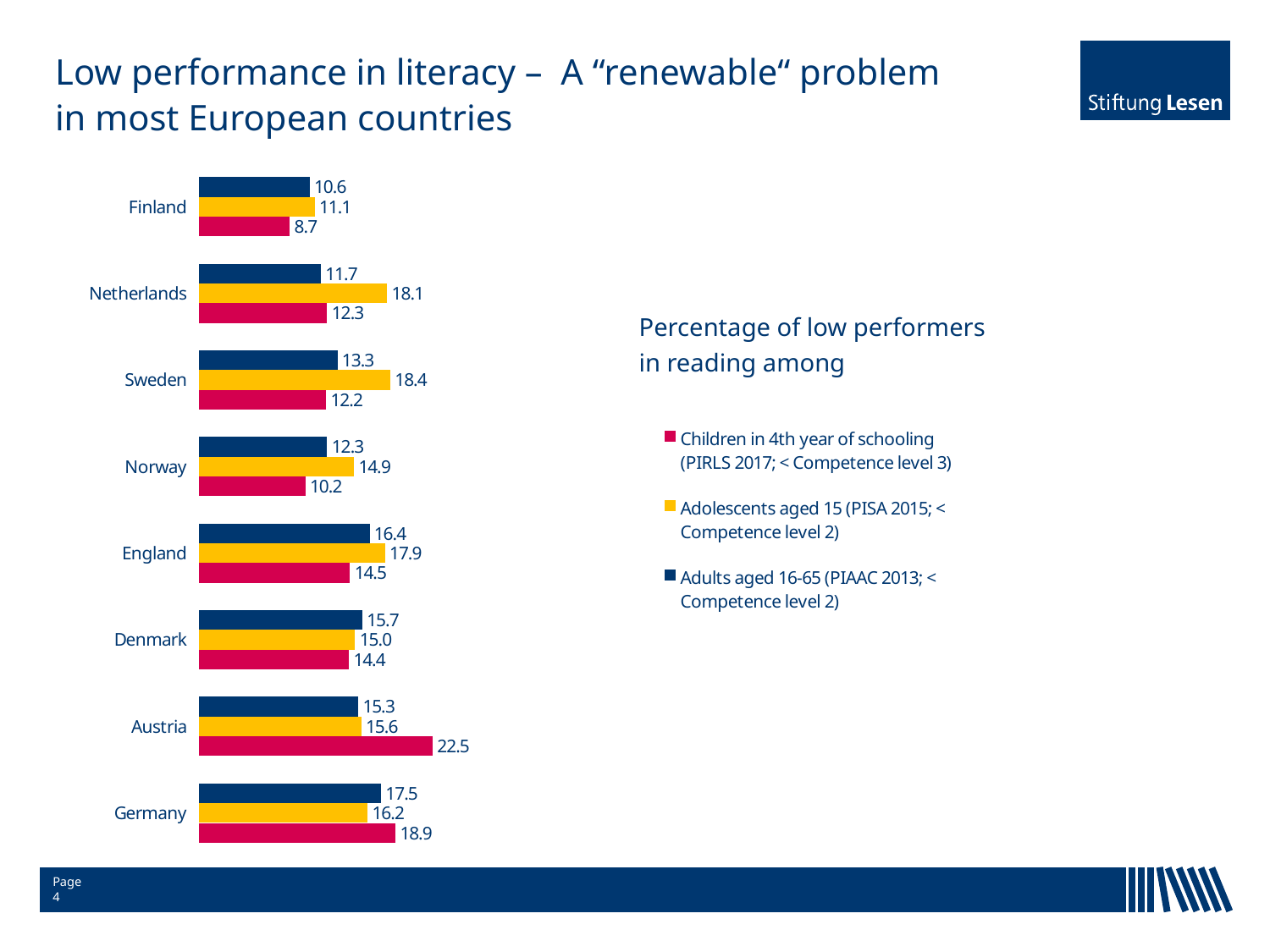
What is the percentage of low performers among adults aged 16-65 (PIAAC 2013) in Germany? 17.5 How many countries are shown in the chart? 8 Which colour represents adolescents aged 15 (PISA 2015) in the chart? Yellow What is the percentage of low performers among adolescents aged 15 (PISA 2015) in Sweden? 18.4 What is the percentage of low performers among children in 4th year of schooling (PIRLS 2017) in Austria? 22.5 What type of chart is shown on the slide? Bar chart Which country has the highest percentage of low performers among adults aged 16-65 (PIAAC 2013)? Germany In the Netherlands, which group has a larger share of low performers: adolescents aged 15 or adults aged 16-65? Adolescents aged 15 How many series does the legend list? 3 What is the difference between the percentage of low-performing children in 4th year of schooling in Austria and in Germany? 3.6 Which country has the lowest percentage of low performers among children in 4th year of schooling (PIRLS 2017)? Finland Which country has the highest percentage of low performers among adolescents aged 15 (PISA 2015)? Sweden